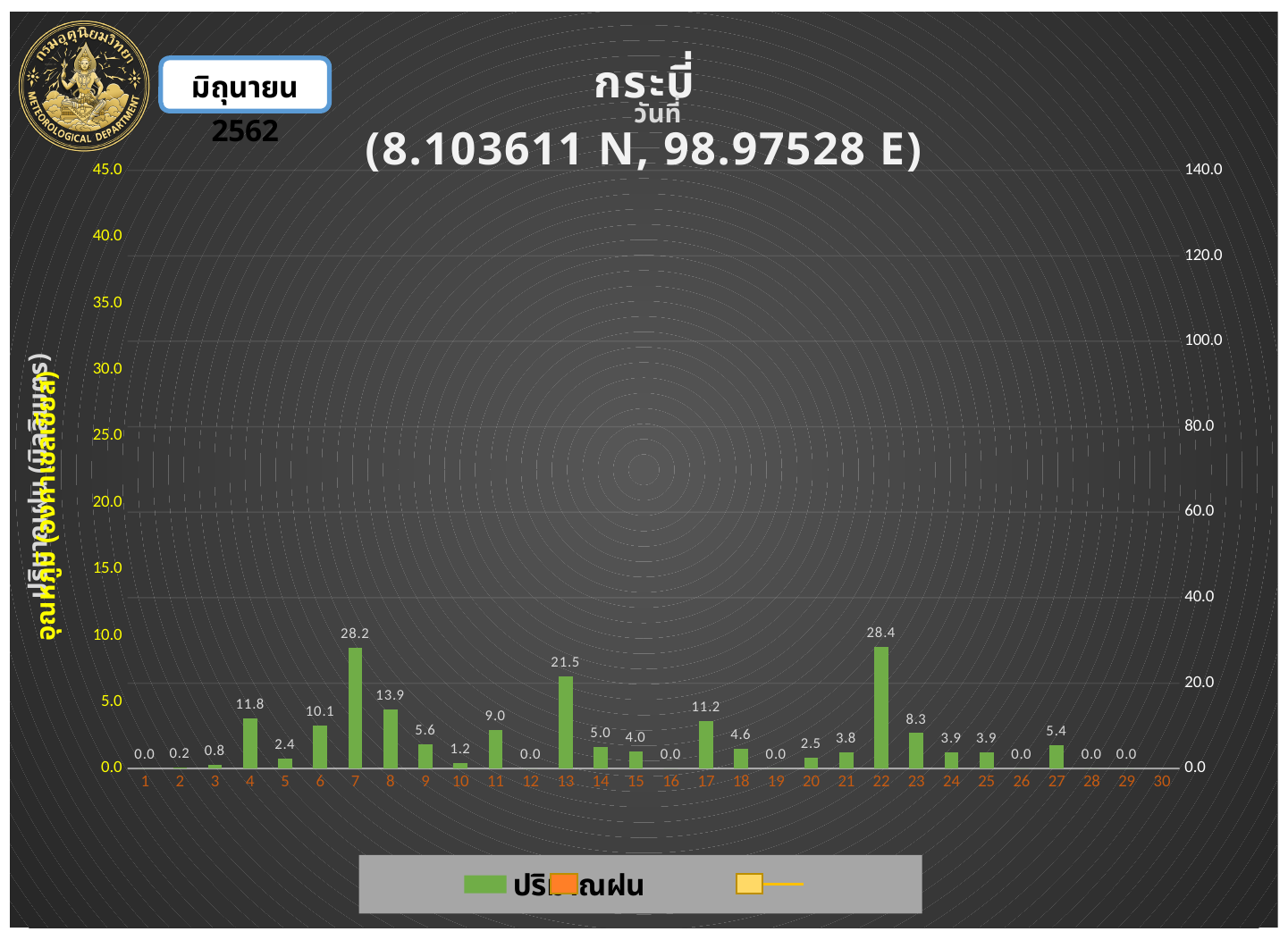
Which day has the highest value? 22 What is the difference between the values for day 22 and day 7? 0.2 What is the value shown for day 7? 28.2 What is the value shown for day 2? 0.2 What kind of chart is this? bar chart What is the value shown for day 23? 8.3 Which is larger, the value for day 9 or the value for day 14? day 9 What is the difference between the values for day 8 and day 6? 3.8 What coordinates are given in the chart title? (8.103611 N, 98.97528 E) What is the value shown for day 13? 21.5 How many days are shown on the x axis? 30 Which is larger, the value for day 4 or the value for day 17? day 4